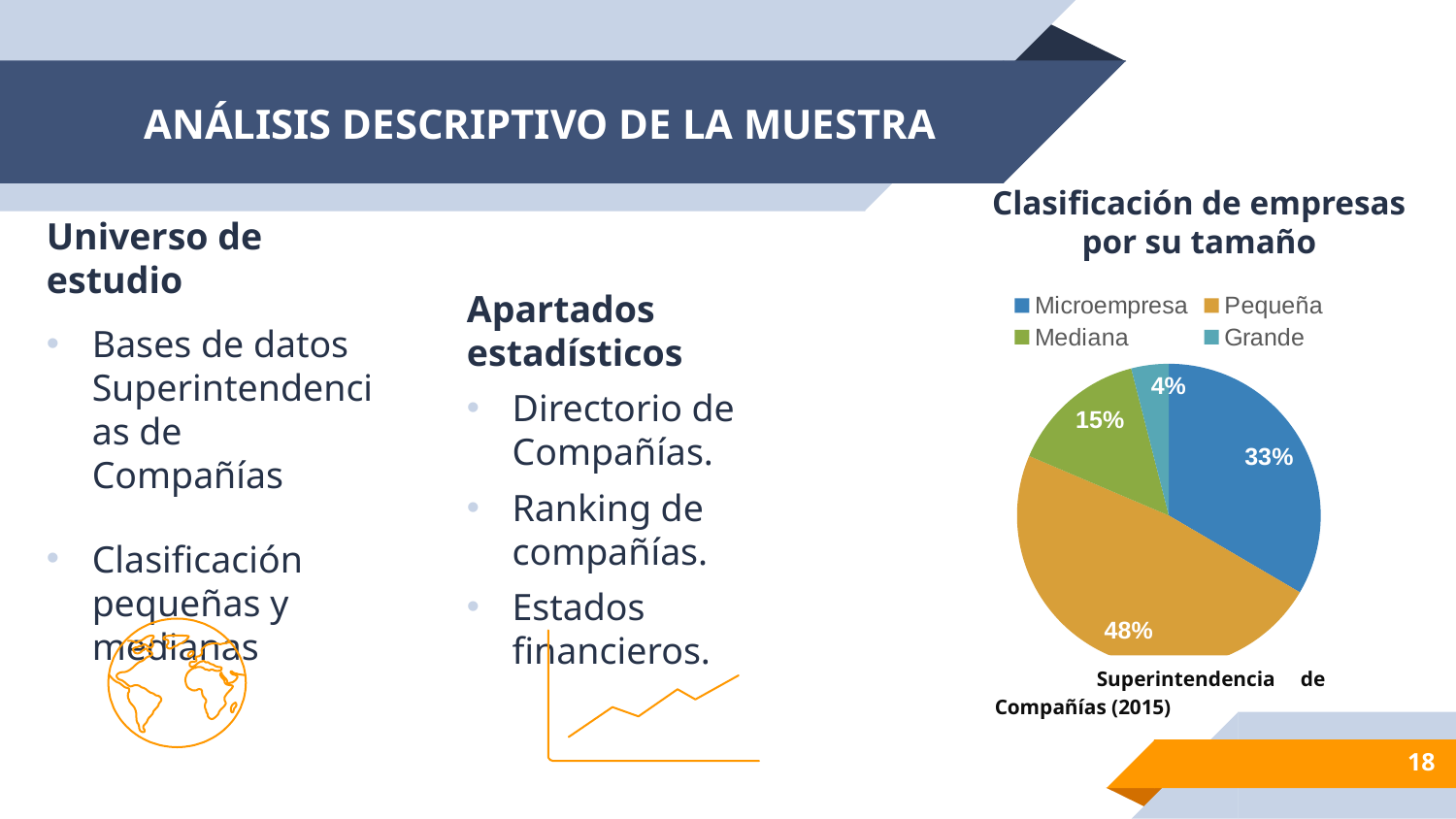
What is the title of the chart on the slide? Clasificación de empresas por su tamaño What share of the pie does Microempresa have? 33% What share of the pie does Grande have? 4% What type of chart is shown on the slide? pie chart What share of the pie does Mediana have? 15% Which is larger, the share for Mediana or the share for Grande? Mediana Which category has the smallest slice of the pie? Grande What is the difference between the shares of Pequeña and Microempresa? 15% Which colour represents Microempresa in the pie chart? blue How many categories does the pie chart show? 4 Which category has the largest slice of the pie? Pequeña